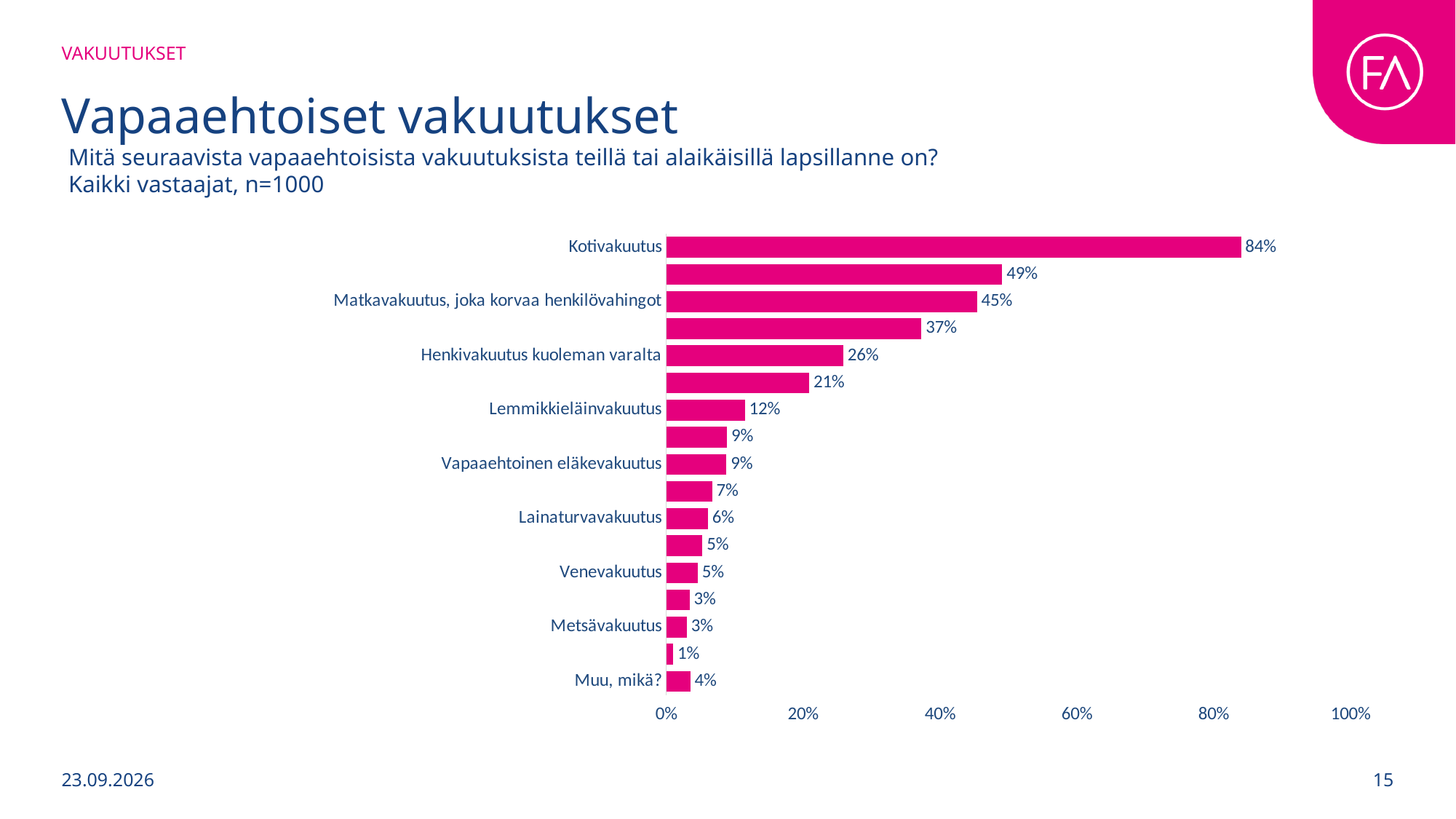
What is the value for Muu, mikä? 4% Which is larger, the value for Henkivakuutus kuoleman varalta or the value for Lemmikkieläinvakuutus? Henkivakuutus kuoleman varalta How many bars are plotted in the chart? 17 What is the value for Matkavakuutus, joka korvaa henkilövahingot? 45% What is the smallest value shown on any bar in the chart? 1% What is the value for Henkivakuutus kuoleman varalta? 26% What is the difference between the values for Kotivakuutus and Matkavakuutus, joka korvaa henkilövahingot? 39 percentage points Which category has the highest value? Kotivakuutus What is the value for Kotivakuutus? 84% Is the value for Kotivakuutus greater or less than 80%? greater What kind of chart is shown on the slide? Bar chart What is the value for Lemmikkieläinvakuutus? 12%